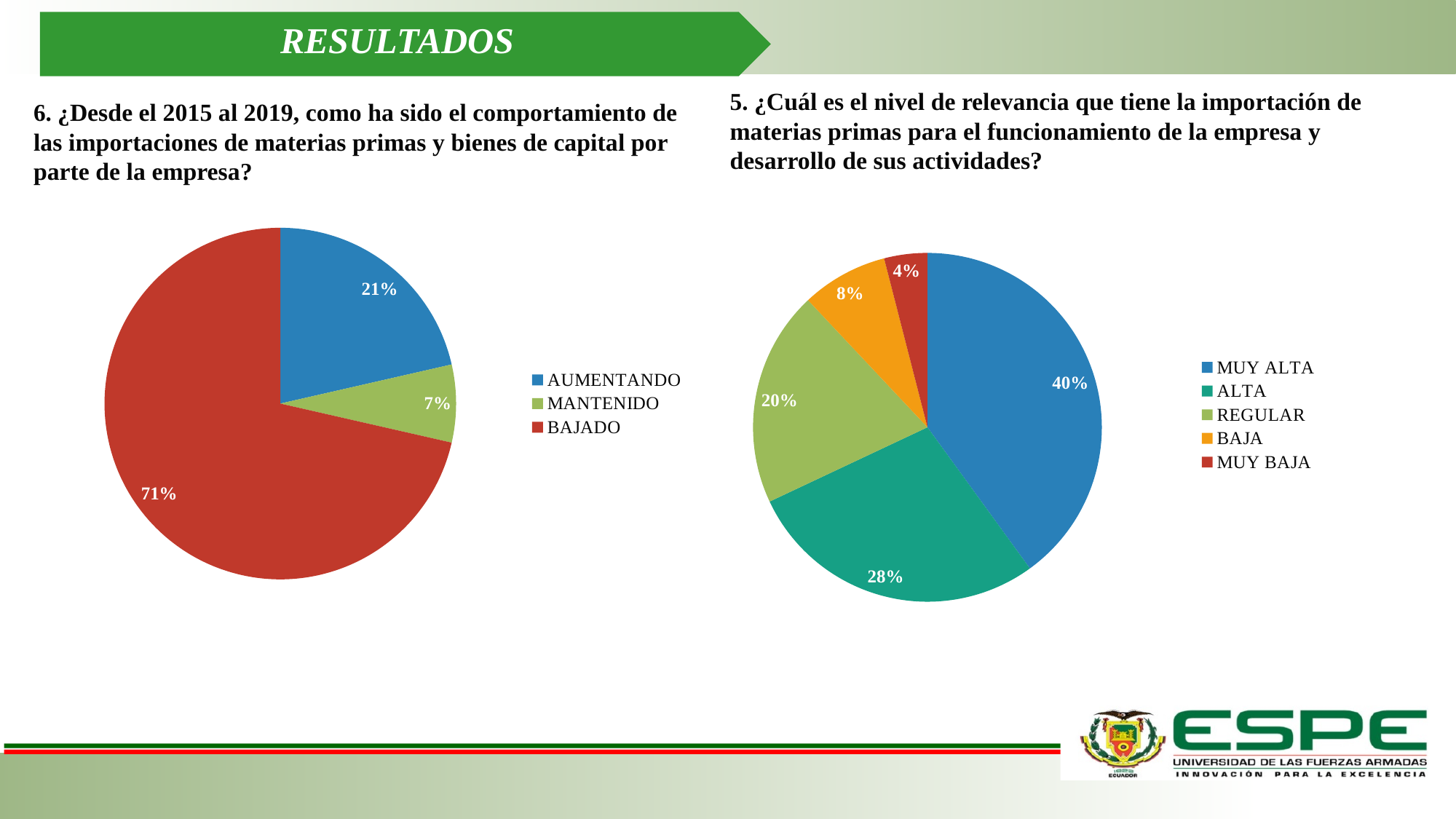
In the left pie chart (question 6), what share does AUMENTANDO have? 21% In the right pie chart (question 5), what share does BAJA have? 8% In the right pie chart (question 5), what share does MUY ALTA have? 40% In the left pie chart (question 6), which category has the smallest share? MANTENIDO What type of chart is used on the left side of the slide (question 6)? Pie chart In the right pie chart (question 5), which is larger, ALTA or REGULAR? ALTA In the left pie chart (question 6), how many categories does the legend list? 3 In the left pie chart (question 6), what share does BAJADO have? 71% In the left pie chart (question 6), what is the difference between the BAJADO and AUMENTANDO shares? 50% In the right pie chart (question 5), which category has the smallest share? MUY BAJA In the right pie chart (question 5), how many categories does the legend list? 5 In the right pie chart (question 5), which category has the largest share? MUY ALTA